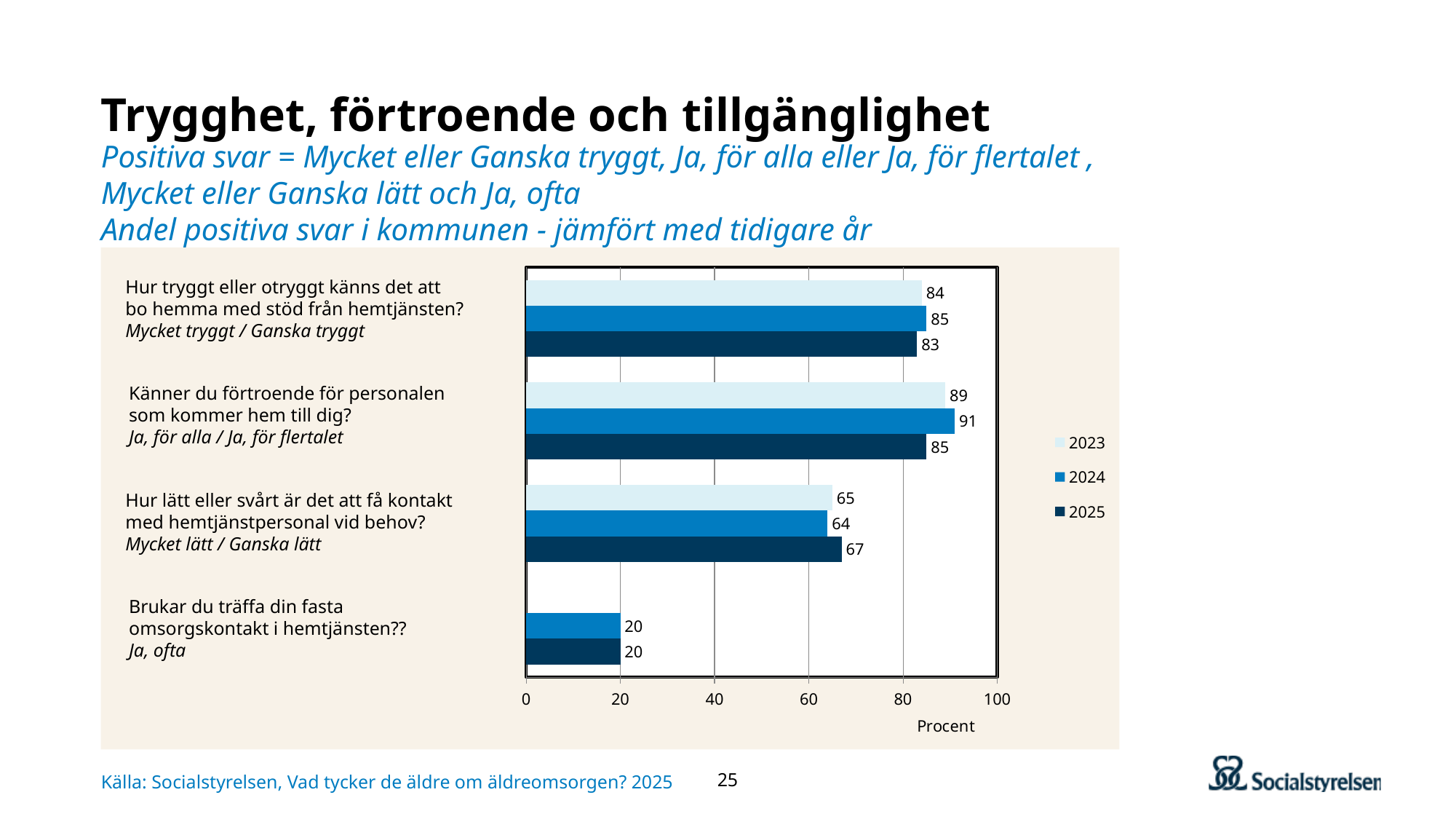
How many series does the legend list? 3 What is the 2025 value for "Hur tryggt eller otryggt känns det att bo hemma med stöd från hemtjänsten?"? 83 What is the 2024 value for "Känner du förtroende för personalen som kommer hem till dig?"? 91 What is the label on the horizontal axis of the chart? Procent Which question has the highest 2024 value? Känner du förtroende för personalen som kommer hem till dig? How many questions (categories) are shown on the chart? 4 Which question has the lowest 2025 value? Brukar du träffa din fasta omsorgskontakt i hemtjänsten? What is the 2025 value for "Brukar du träffa din fasta omsorgskontakt i hemtjänsten?"? 20 What kind of chart is shown on the slide? bar chart For "Hur lätt eller svårt är det att få kontakt med hemtjänstpersonal vid behov?", which year has the larger value, 2024 or 2025? 2025 What is the 2023 value for "Hur lätt eller svårt är det att få kontakt med hemtjänstpersonal vid behov?"? 65 What is the difference between the 2024 and 2025 values for "Känner du förtroende för personalen som kommer hem till dig?"? 6